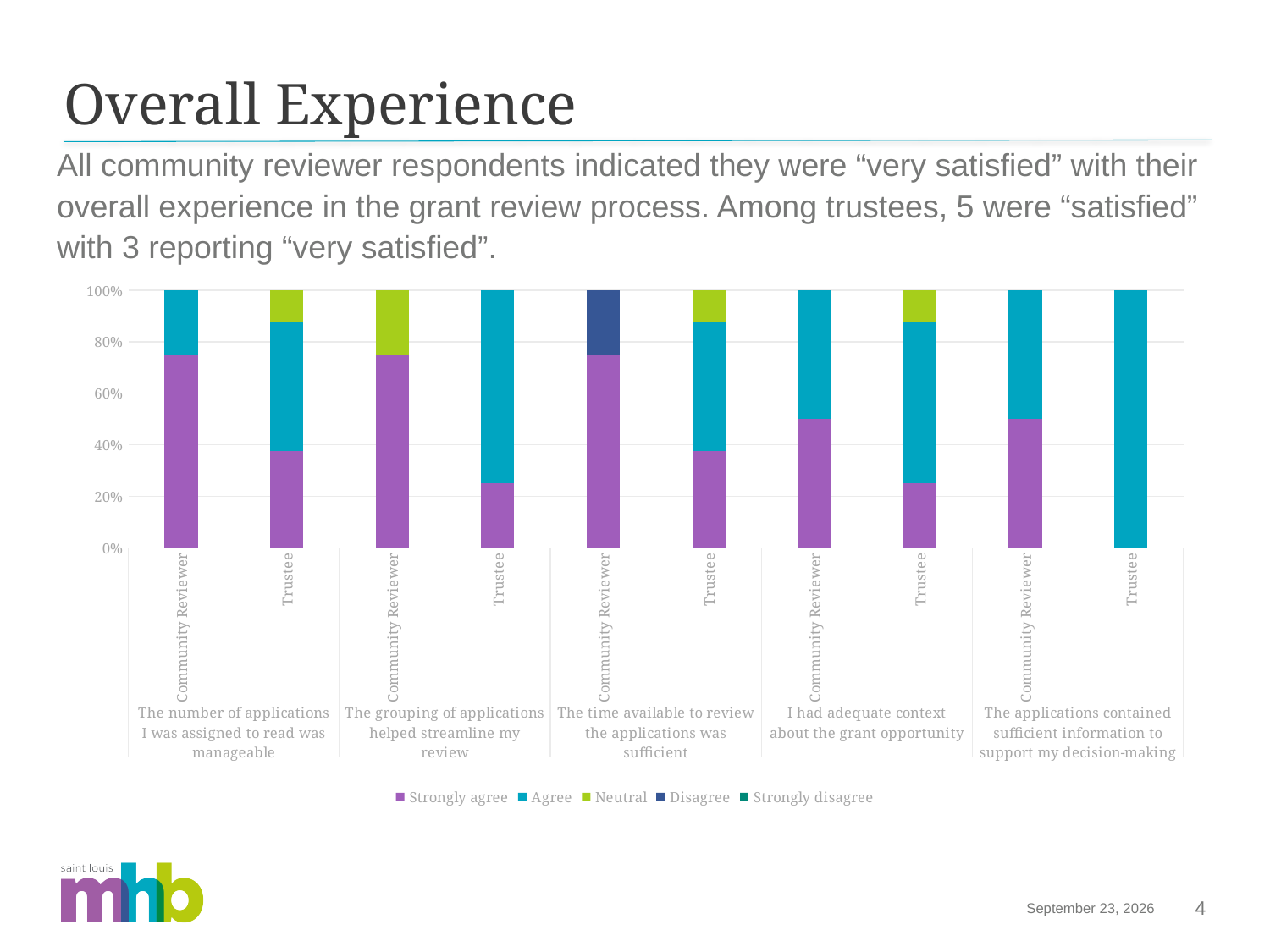
Is the Strongly agree share for Trustee on "The grouping of applications helped streamline my review" greater or less than 40%? less How many survey statements are shown along the x axis of the chart? 5 Which response category makes up the entire Trustee bar for "The applications contained sufficient information to support my decision-making"? Agree Is the Strongly agree share for Community Reviewer on "The number of applications I was assigned to read was manageable" greater or less than 60%? greater How many series does the legend list? 5 What is the total height of the Trustee bar for "The applications contained sufficient information to support my decision-making"? 100% For "I had adequate context about the grant opportunity", which group has the larger Strongly agree share, Community Reviewer or Trustee? Community Reviewer What kind of chart is shown on the slide? Stacked bar chart Is the Strongly agree share for Community Reviewer on "The time available to review the applications was sufficient" greater or less than 60%? greater How many bars are plotted in the chart? 10 Which response category is shown in purple in the legend? Strongly agree Which bar is the only one that includes a Disagree segment? Community Reviewer, The time available to review the applications was sufficient